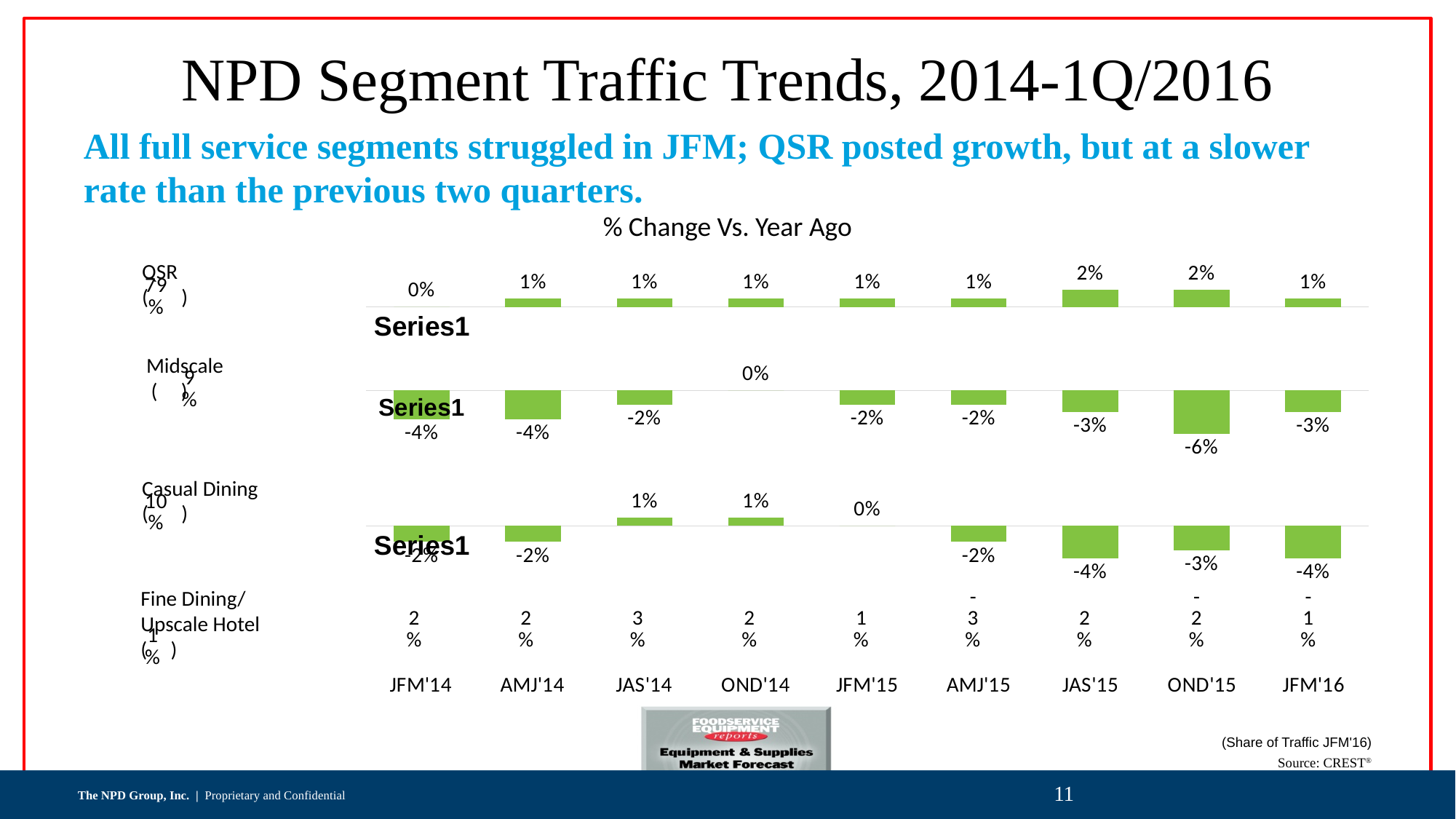
In the Midscale chart, what is the value for OND'15? -6% How many quarters are shown along the x axis of the QSR chart? 9 In the Midscale chart, which quarter has the lowest value? OND'15 In the Casual Dining chart, what is the value for OND'14? 1% In the Midscale chart, what is the value for OND'14? 0% What is the title shown above the charts? % Change Vs. Year Ago In the QSR chart, what is the % change vs. year ago for JAS'15? 2% In the QSR chart, what is the difference between the values for JAS'15 and JFM'16? 1 percentage point In the Midscale chart, which is larger, the value for JFM'14 or the value for JAS'14? JAS'14 What kind of chart is used for the QSR segment? Bar chart In the Casual Dining chart, what is the value for JFM'16? -4% In the Casual Dining chart, which is larger, the value for JAS'14 or the value for JAS'15? JAS'14